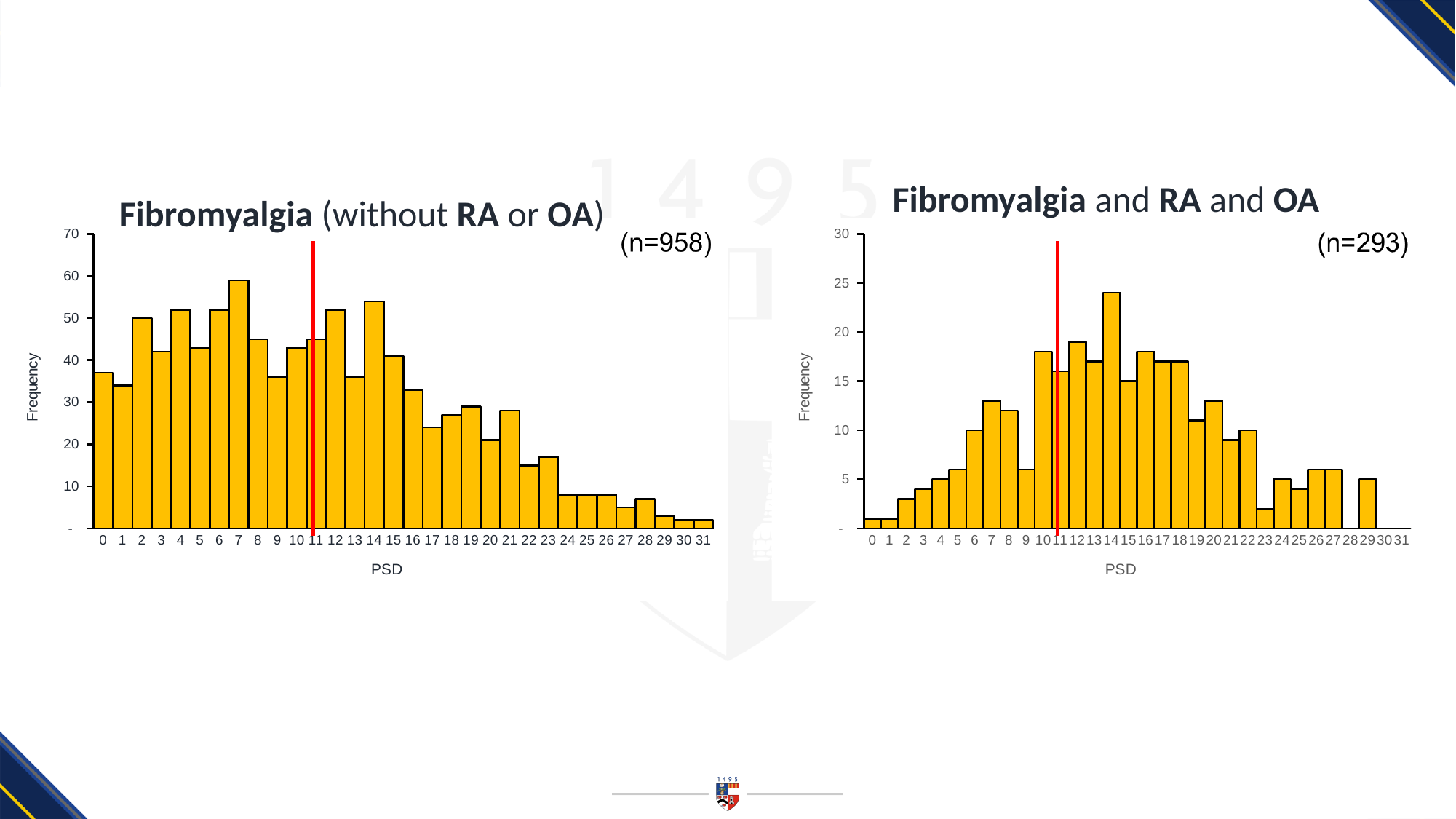
In the 'Fibromyalgia (without RA or OA)' chart, which has the higher frequency, PSD 2 or PSD 17? PSD 2 In the 'Fibromyalgia and RA and OA' chart, which PSD value has the highest frequency? 14 How many PSD categories are shown on the x axis of the 'Fibromyalgia (without RA or OA)' chart? 32 In the 'Fibromyalgia and RA and OA' chart, which has the higher frequency, PSD 7 or PSD 24? PSD 7 What kind of chart is the 'Fibromyalgia (without RA or OA)' chart? bar chart In the 'Fibromyalgia (without RA or OA)' chart, which PSD value has the highest frequency? 7 What sample size (n) is shown for the 'Fibromyalgia and RA and OA' chart? n=293 What is the x-axis label on the 'Fibromyalgia (without RA or OA)' chart? PSD In the 'Fibromyalgia and RA and OA' chart, is the frequency for PSD 14 greater or less than 20? greater In the 'Fibromyalgia (without RA or OA)' chart, is the frequency for PSD 22 greater or less than 20? less In the 'Fibromyalgia (without RA or OA)' chart, is the frequency for PSD 7 greater or less than 50? greater